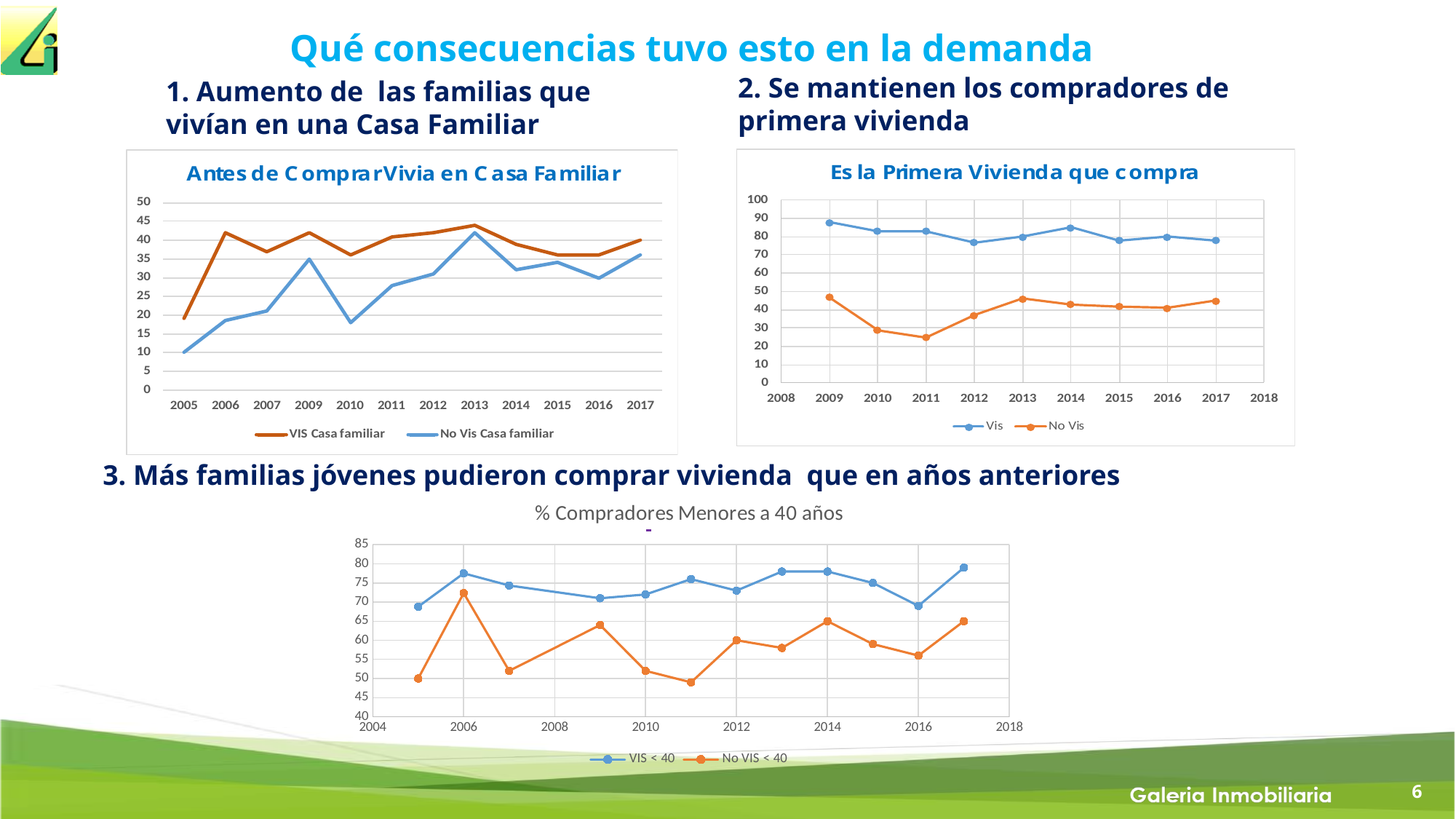
In the chart 'Es la Primera Vivienda que compra', how many years are plotted for the Vis series? 9 In the chart '% Compradores Menores a 40 años', which year has the highest value for No VIS < 40? 2006 In the chart 'Es la Primera Vivienda que compra', which year has the lowest value for No Vis? 2011 In the chart 'Es la Primera Vivienda que compra', which series is higher in 2014, Vis or No Vis? Vis In the chart 'Es la Primera Vivienda que compra', is the value for Vis in 2009 greater or less than 80? greater What kind of chart is 'Es la Primera Vivienda que compra'? line chart In the chart 'Antes de Comprar Vivia en Casa Familiar', how many series does the legend list? 2 In the chart 'Antes de Comprar Vivia en Casa Familiar', which year has the lowest value for VIS Casa familiar? 2005 In the chart '% Compradores Menores a 40 años', what colour is the line for VIS < 40? blue In the chart 'Antes de Comprar Vivia en Casa Familiar', is the value for No Vis Casa familiar in 2005 greater or less than 15? less In the chart 'Antes de Comprar Vivia en Casa Familiar', which series is higher in 2010, VIS Casa familiar or No Vis Casa familiar? VIS Casa familiar